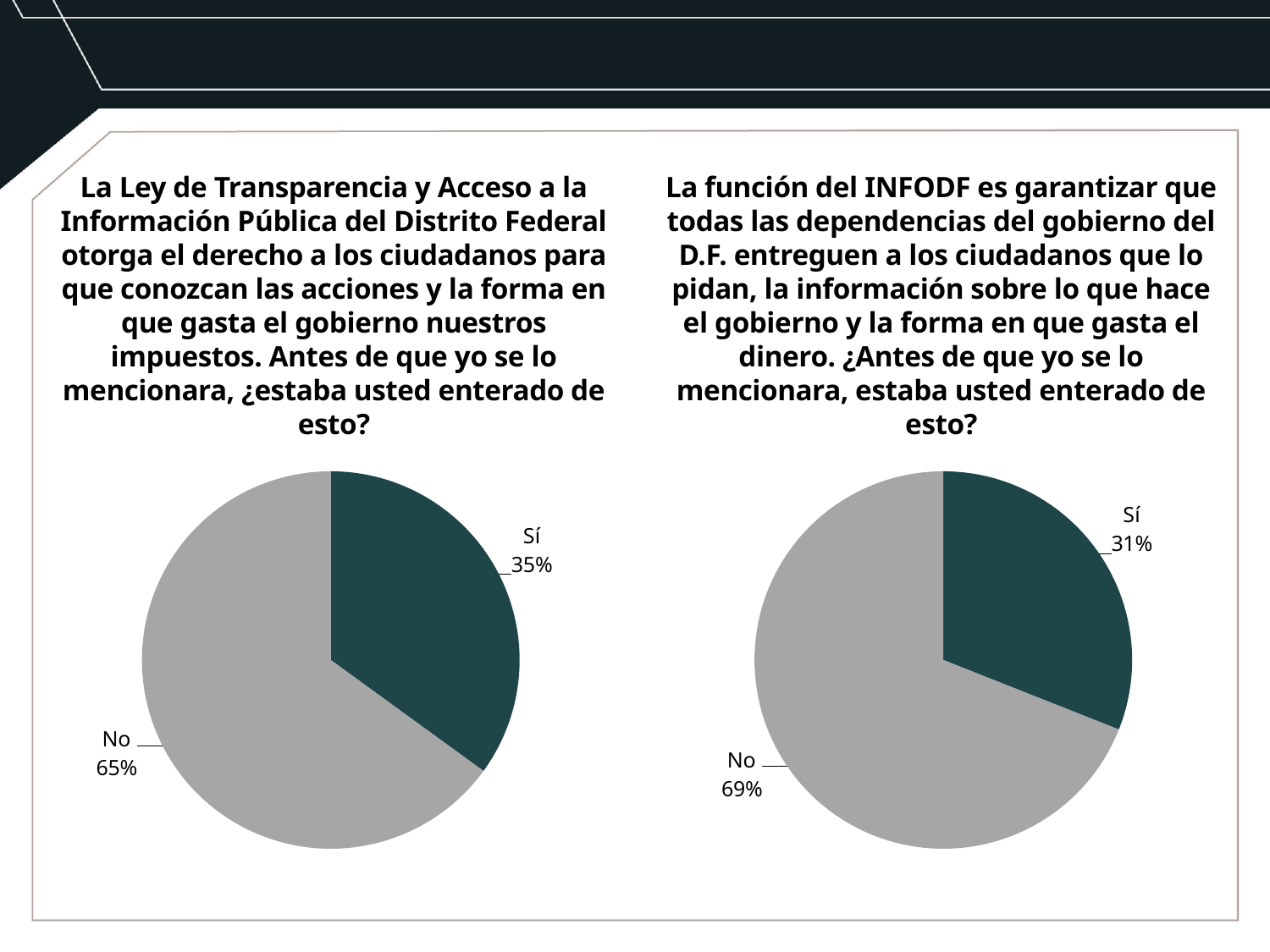
What type of chart is used on the right side of the slide (about the función del INFODF)? Pie chart In the right pie chart (about the función del INFODF), which response has the smallest slice? Sí In the left pie chart (about the Ley de Transparencia), what share of respondents answered Sí? 35% In the right pie chart (about the función del INFODF), what share of respondents answered No? 69% In the left pie chart (about the Ley de Transparencia), what share of respondents answered No? 65% In the right pie chart (about the función del INFODF), what share of respondents answered Sí? 31% Which chart has the larger Sí share, the left pie chart (Ley de Transparencia) or the right pie chart (función del INFODF)? The left pie chart (Ley de Transparencia) In the left pie chart (about the Ley de Transparencia), which response has the largest slice? No How many slices does the left pie chart (about the Ley de Transparencia) have? 2 In the left pie chart (about the Ley de Transparencia), what is the difference in percentage points between No and Sí? 30 percentage points In the right pie chart (about the función del INFODF), what colour is the Sí slice? Dark teal In the right pie chart (about the función del INFODF), what is the difference in percentage points between No and Sí? 38 percentage points